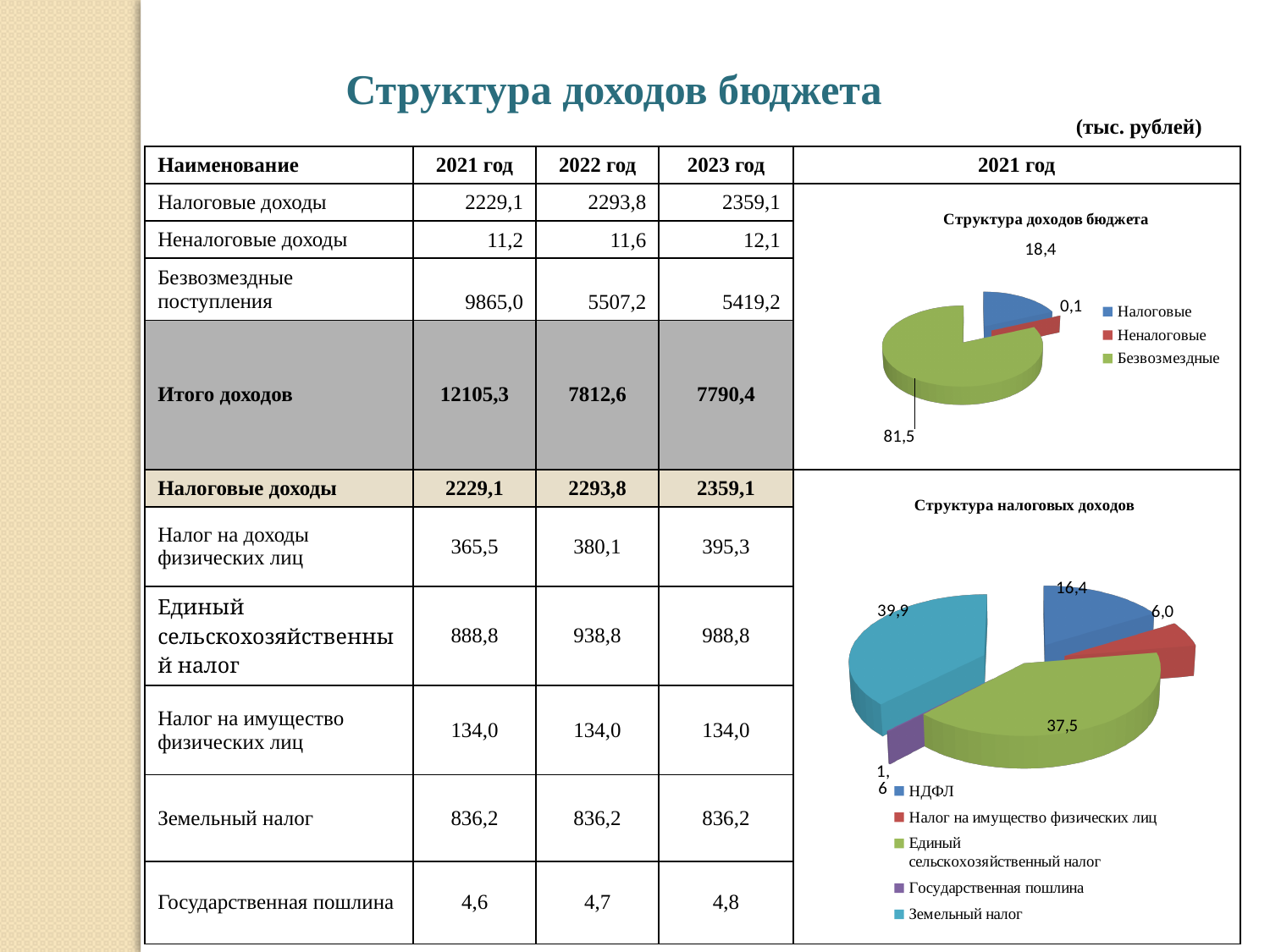
In the chart titled "Структура доходов бюджета", how many categories does the legend list? 3 In the chart titled "Структура доходов бюджета", what value is shown for the "Налоговые" slice? 18,4 In the chart titled "Структура налоговых доходов", what is the difference between the values for "НДФЛ" and "Налог на имущество физических лиц"? 10,4 In the chart titled "Структура доходов бюджета", what value is shown for the "Безвозмездные" slice? 81,5 What type of chart is the chart titled "Структура доходов бюджета"? Pie chart In the chart titled "Структура налоговых доходов", what value is shown for "Земельный налог"? 39,9 In the chart titled "Структура налоговых доходов", which category has the smallest slice? Государственная пошлина In the chart titled "Структура налоговых доходов", how many categories does the legend list? 5 In the chart titled "Структура налоговых доходов", what value is shown for "Единый сельскохозяйственный налог"? 37,5 In the chart titled "Структура доходов бюджета", which category has the smallest slice? Неналоговые In the chart titled "Структура налоговых доходов", what value is shown for "НДФЛ"? 16,4